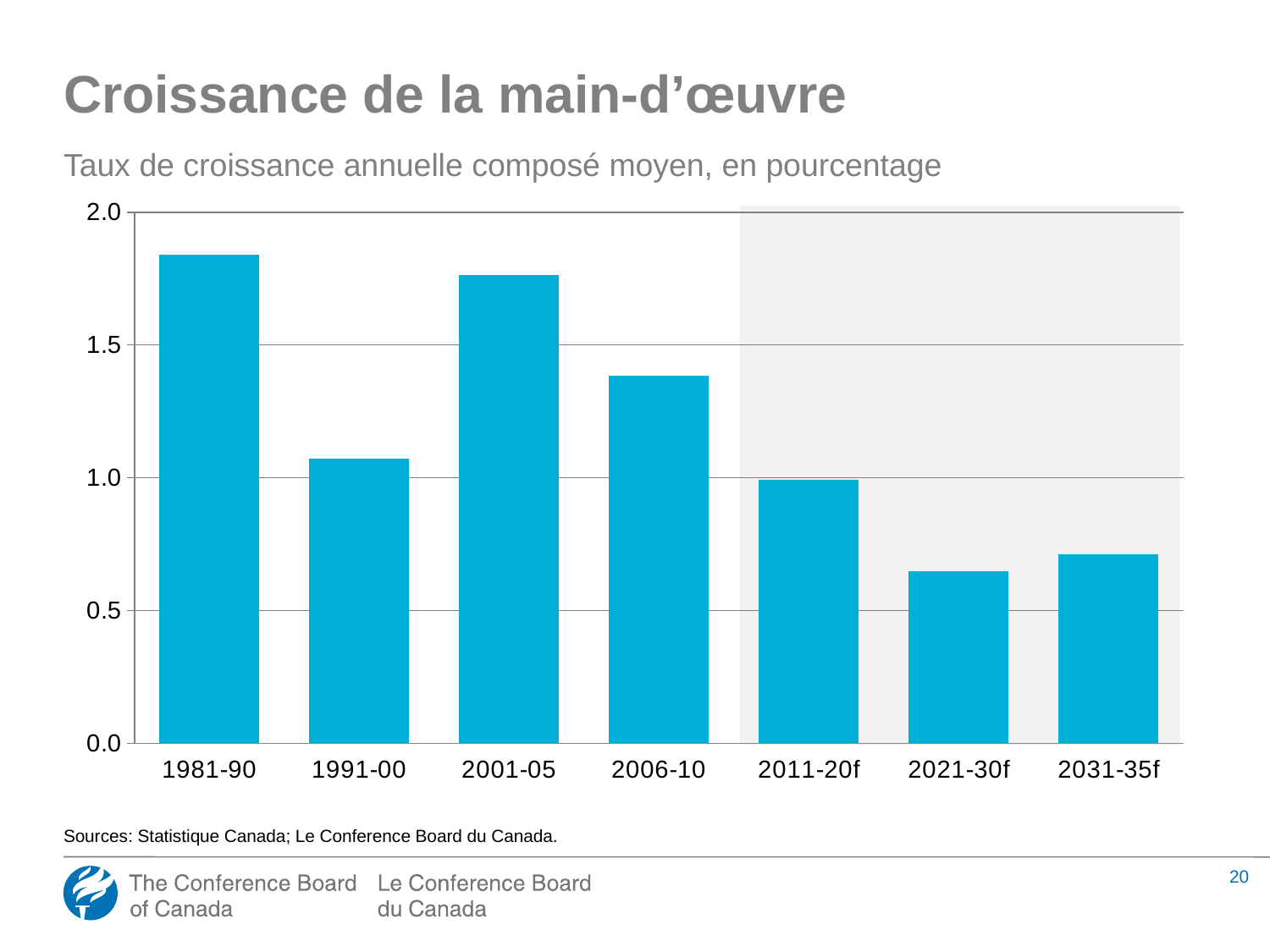
Is the value for 1981-90 greater or less than 1.5? greater How many periods are shown on the x axis of the chart? 7 What kind of chart is shown on the slide? bar chart Which period has the lowest labour force growth rate? 2021-30f Is the value for 2021-30f greater or less than 0.5? greater Is the value for 1991-00 greater or less than 1.5? less Which period has the highest labour force growth rate? 1981-90 Which is larger, the value for 2006-10 or the value for 2011-20f? 2006-10 What is the title of the chart on the slide? Croissance de la main-d'œuvre Which is larger, the value for 1981-90 or the value for 2001-05? 1981-90